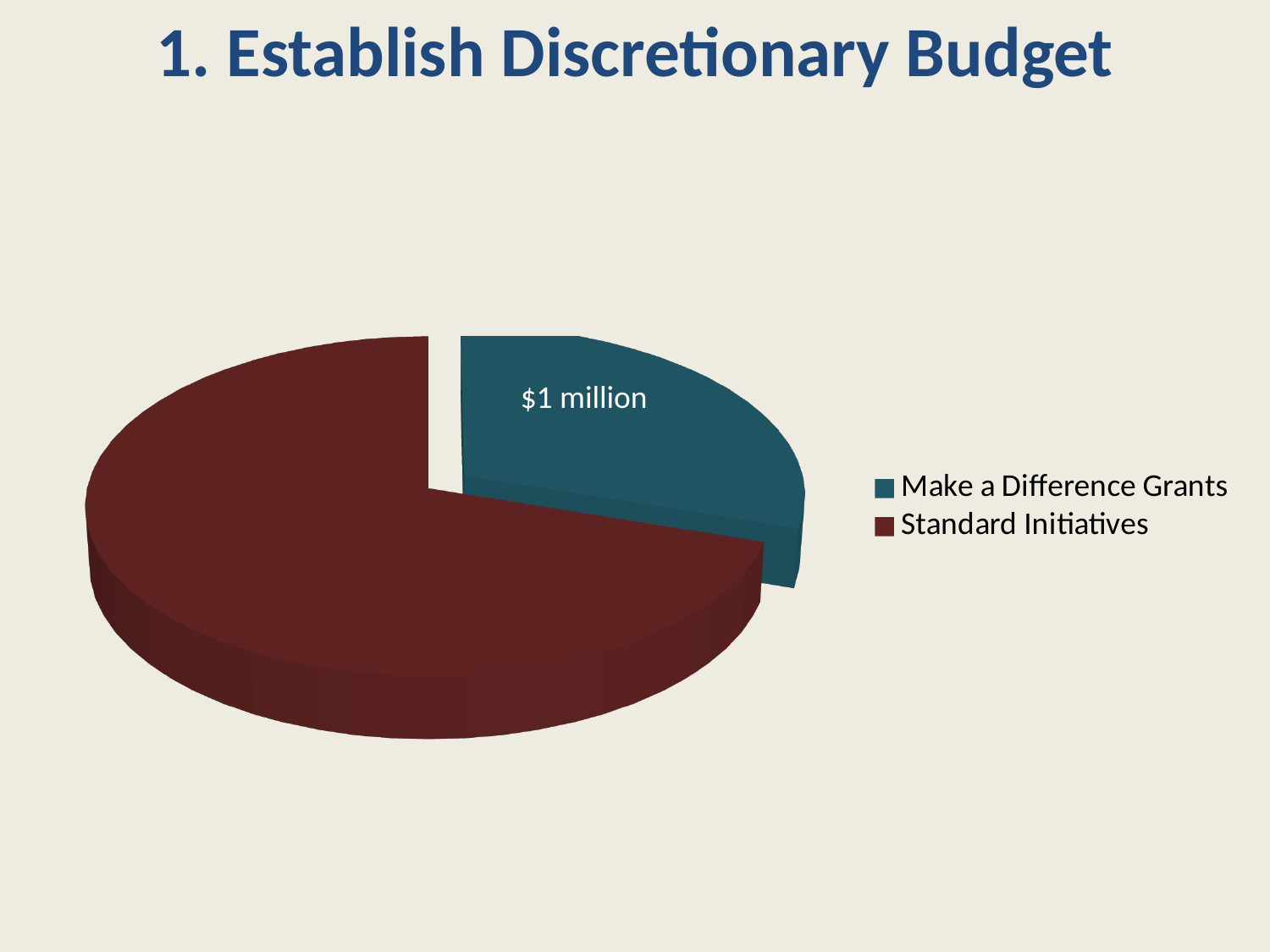
Which is larger, the Standard Initiatives slice or the Make a Difference Grants slice? Standard Initiatives How many entries does the legend list? 2 What kind of chart is shown on the slide? pie chart How many slices does the pie chart have? 2 What colour is the Make a Difference Grants slice? teal What value is labelled on the Make a Difference Grants slice? $1 million What is the title of the slide containing the pie chart? 1. Establish Discretionary Budget Which slice of the pie is the largest? Standard Initiatives Which slice of the pie is the smallest? Make a Difference Grants